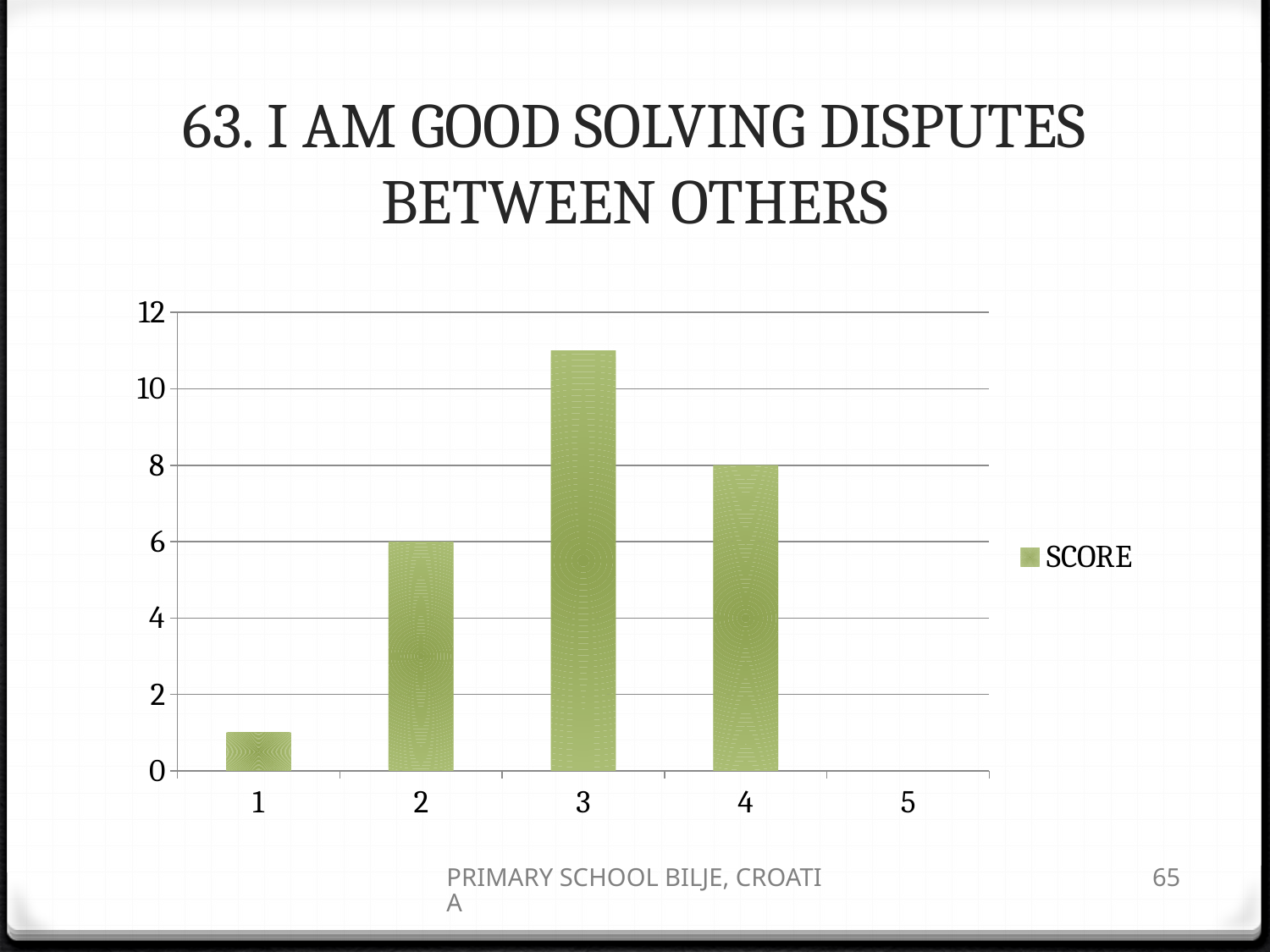
Do the values rise or fall from category 3 to category 4? fall What is the value for category 2? 6 Which category has the highest value? 3 Is the value for category 3 greater or less than 10? greater How many series does the legend list? 1 Is the value for category 1 greater or less than 2? less What is the value for category 4? 8 What kind of chart is shown on the slide? bar chart Which is larger, the value for category 2 or the value for category 4? category 4 What is the name of the series shown in the legend? SCORE How many categories are shown on the x axis? 5 What is the difference between the values for category 4 and category 2? 2